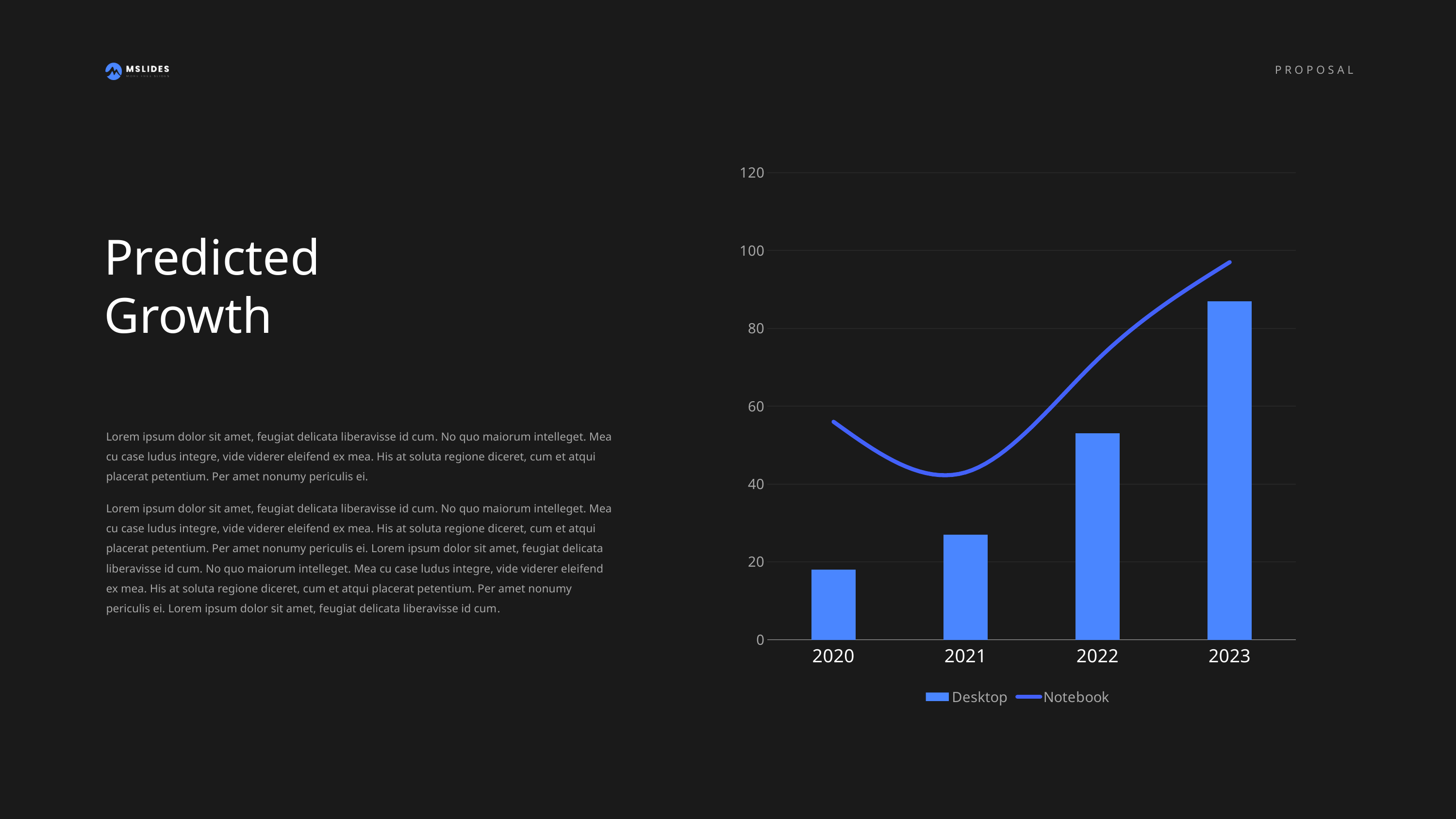
In which year is the Desktop bar the tallest? 2023 Is the Desktop value for 2023 greater or less than 80? greater Is the Desktop value for 2020 greater or less than 20? less Is the Notebook value for 2021 greater or less than 60? less In which year does the Notebook line reach its lowest point? 2021 In which year is the Desktop bar the shortest? 2020 How many years are shown on the x axis of the chart? 4 In which year does the Notebook line reach its highest point? 2023 How many series does the chart's legend list? 2 What kind of chart is shown on the slide? A combination bar and line chart Which series are listed in the chart's legend? Desktop and Notebook Do the Desktop values rise or fall from 2020 to 2023? rise